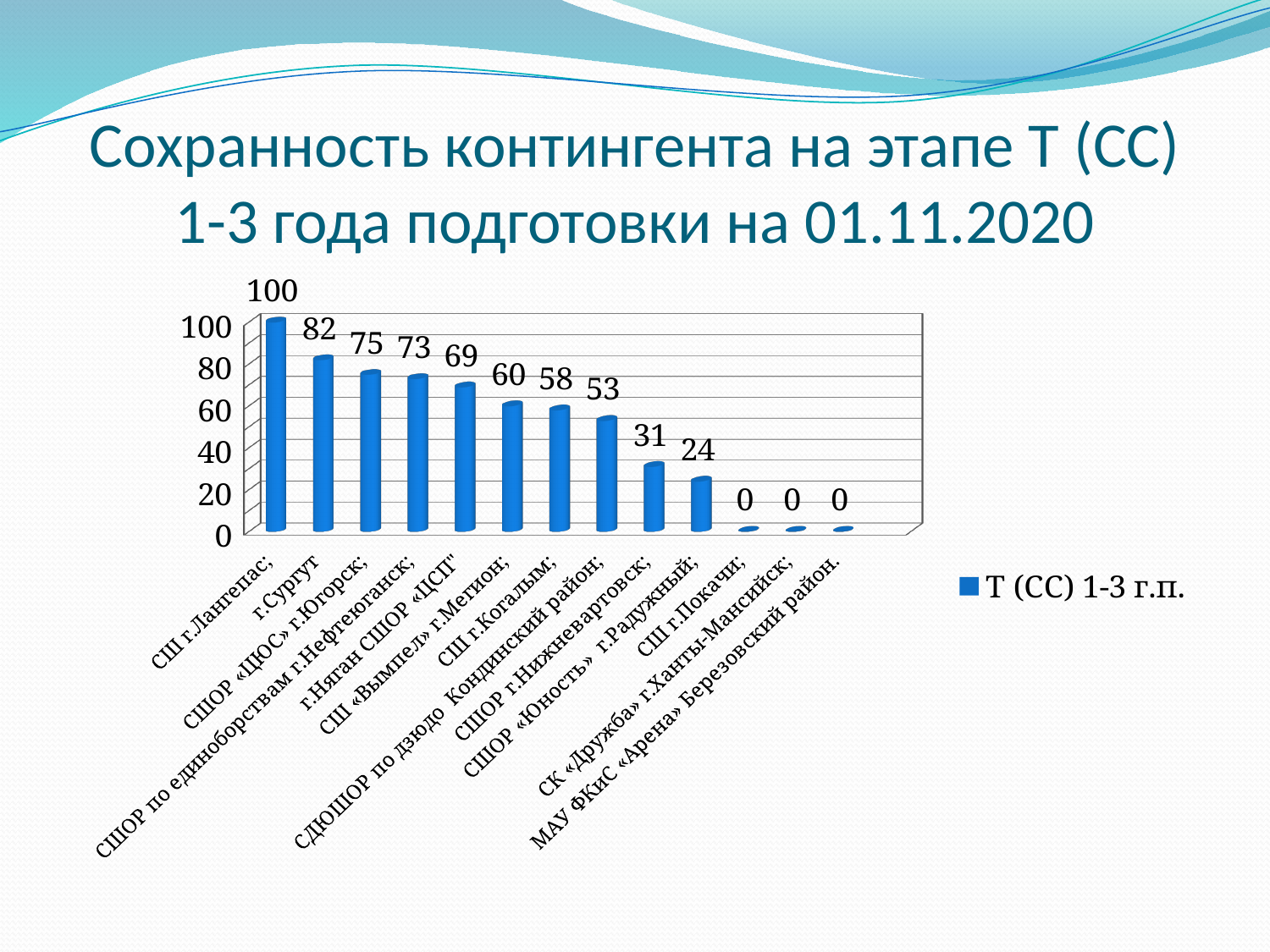
How many categories have a value of 0? 3 How many series does the legend list? 1 What is the value for г.Сургут? 82 What type of chart is shown on the slide? bar chart Which is larger, the value for СШ г.Когалым or the value for СДЮШОР по дзюдо Кондинский район? СШ г.Когалым What is the legend entry for the series? Т (СС) 1-3 г.п. What is the value for СШ «Вымпел» г.Мегион? 60 What is the value for СШ г.Лангепас? 100 What is the difference between the values for г.Сургут and СШОР г.Нижневартовск? 51 How many categories are shown on the x axis? 13 Which category has the highest value? СШ г.Лангепас What is the value for СШОР «Юность» г.Радужный? 24